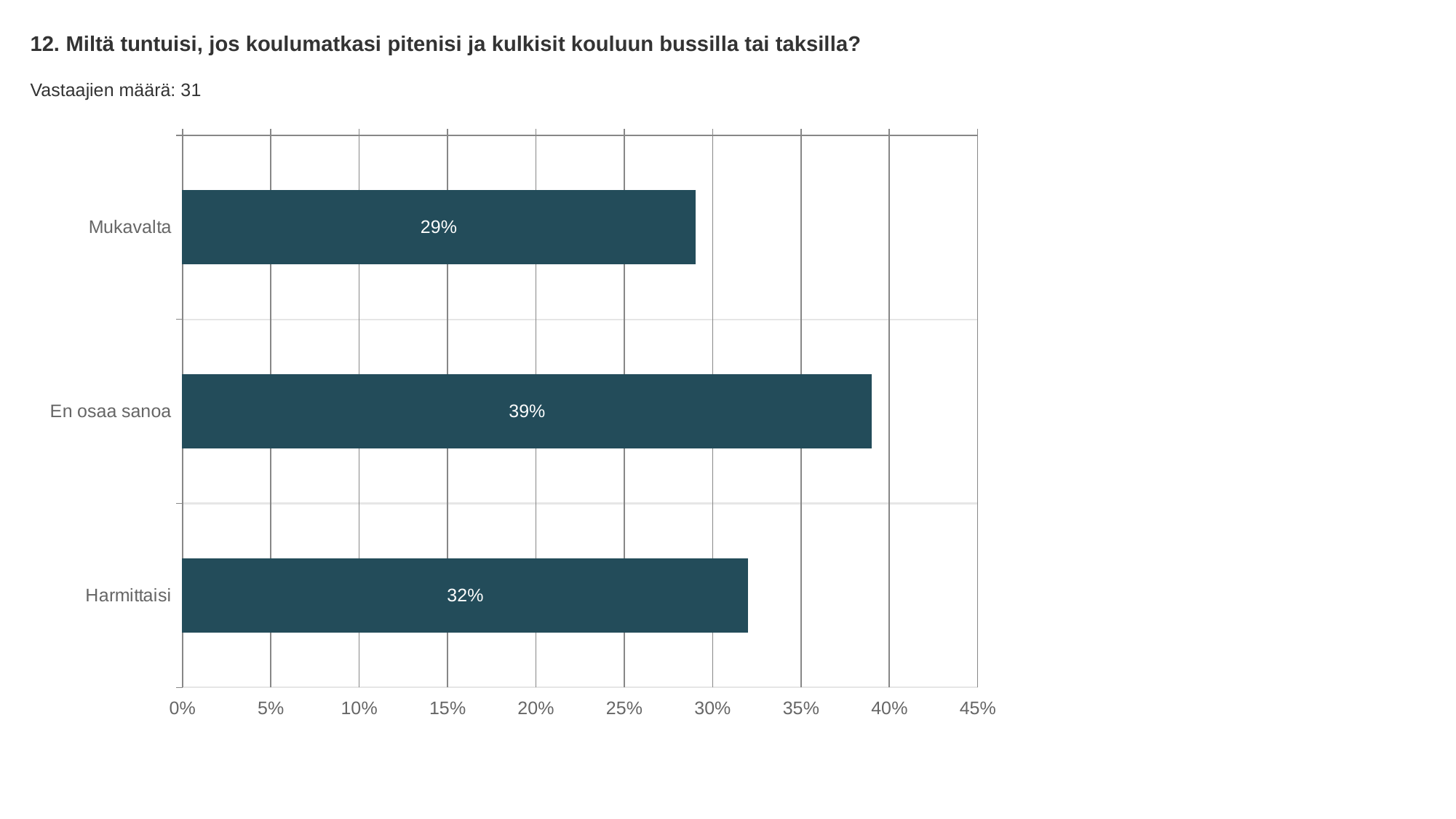
What kind of chart is shown on the slide? bar chart Which is larger, the value for Harmittaisi or the value for Mukavalta? Harmittaisi What is the value for En osaa sanoa? 39% Which category has the highest value? En osaa sanoa What is the difference between the values for Harmittaisi and Mukavalta? 3% How many respondents (Vastaajien määrä) are stated on the slide? 31 What is the value for Mukavalta? 29% Is the value for En osaa sanoa greater or less than 35%? greater Which category has the lowest value? Mukavalta What is the value for Harmittaisi? 32% What is the difference between the values for En osaa sanoa and Mukavalta? 10% How many categories are shown in the chart? 3